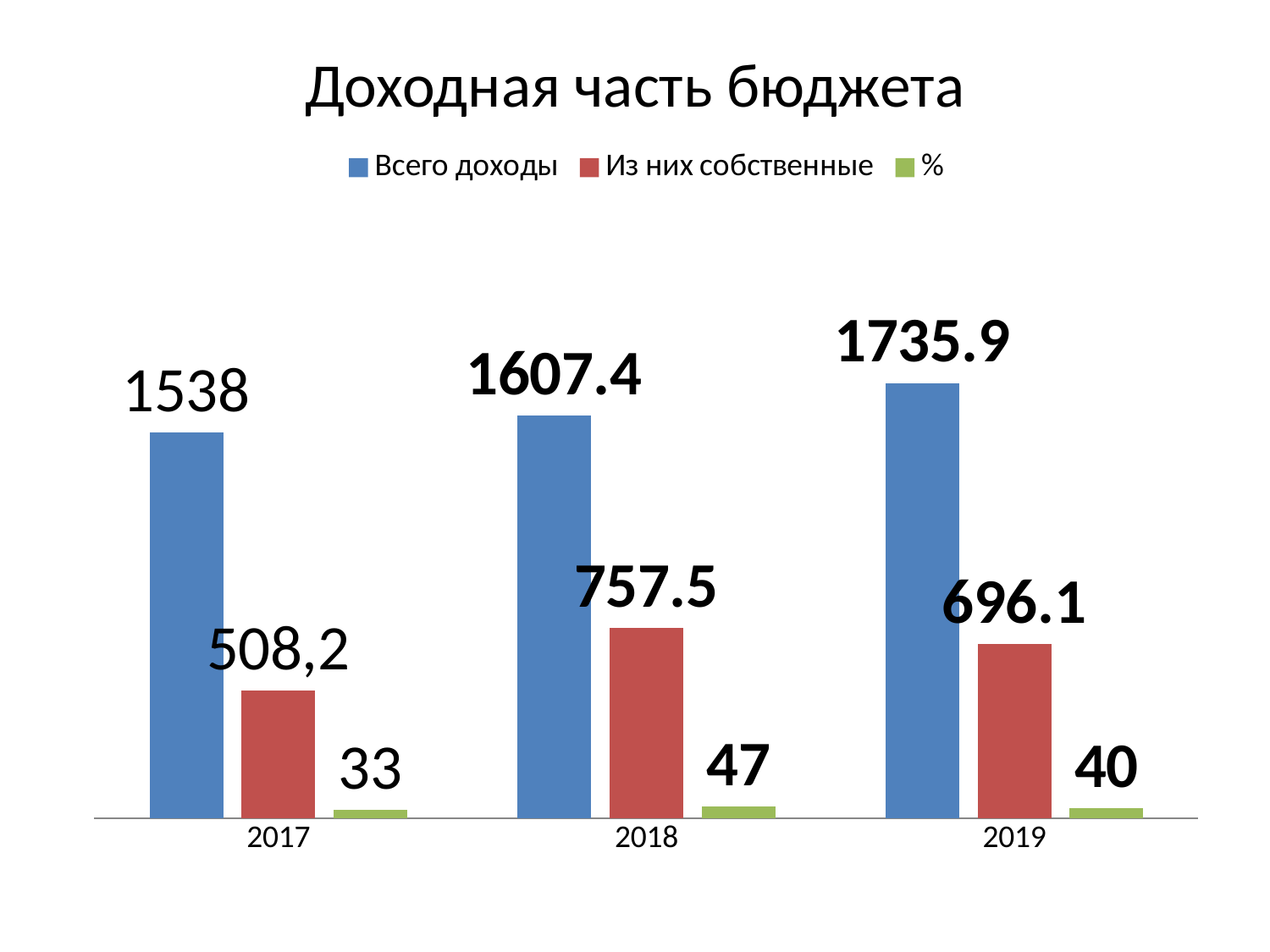
What is the value of Из них собственные for 2017? 508,2 How many series does the legend list? 3 What is the difference between Всего доходы in 2019 and in 2017? 197.9 What is the value of Всего доходы for 2018? 1607.4 Which year has the lowest value for Из них собственные? 2017 What is the % value for 2019? 40 What kind of chart is shown on the slide? Bar chart Which year has the highest % value? 2018 How many years are shown on the x axis? 3 What is the difference between the % value in 2018 and in 2017? 14 Which is larger: Из них собственные in 2018 or in 2019? 2018 Which year has the highest value for Всего доходы? 2019